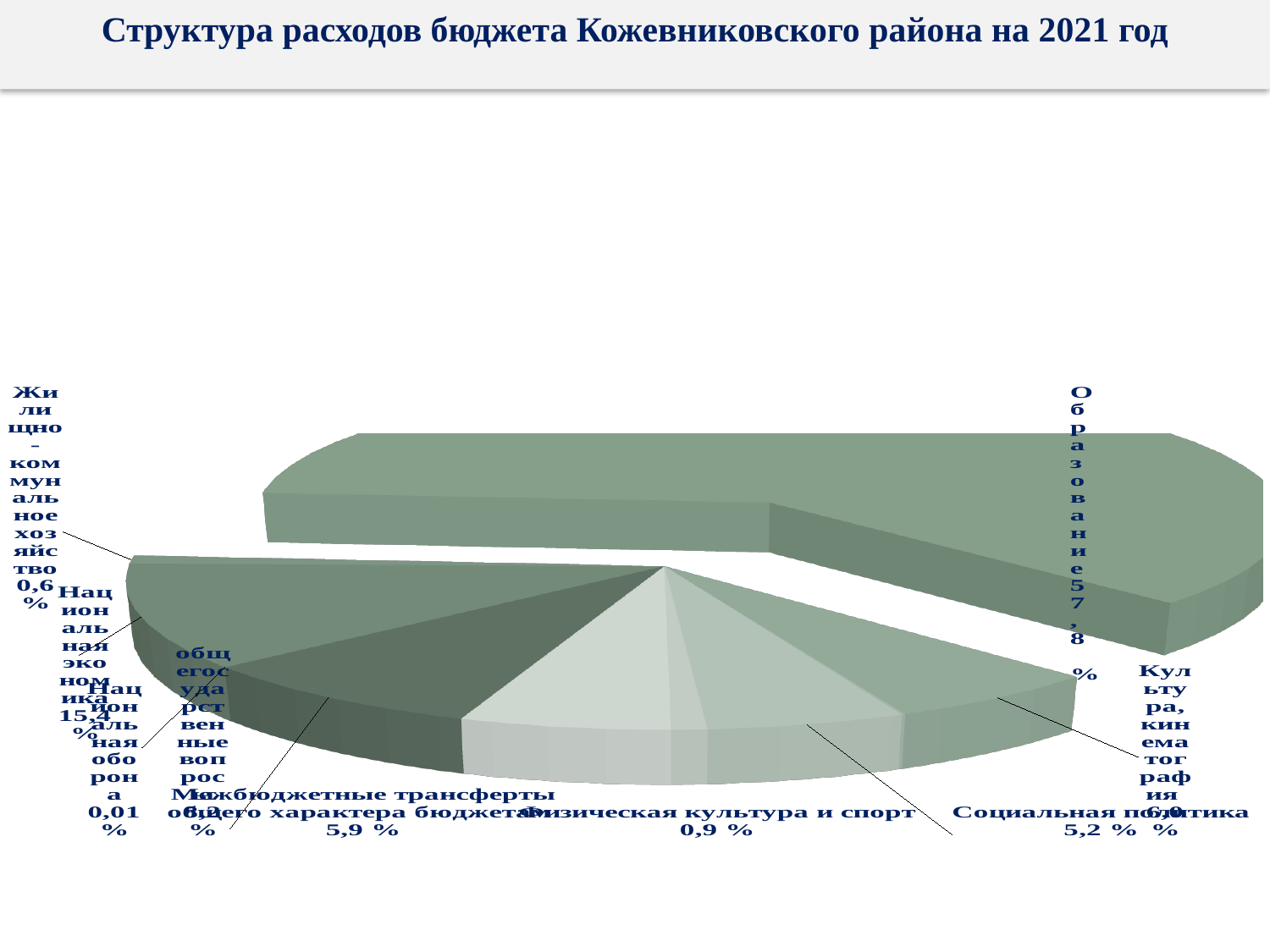
What share of the budget expenditure goes to Социальная политика? 5,2 % Which has a larger share: Социальная политика or Культура, кинематография? Культура, кинематография What share of the budget expenditure goes to Физическая культура и спорт? 0,9 % What share of the budget expenditure goes to Образование? 57,8 % What is the title of the chart? Структура расходов бюджета Кожевниковского района на 2021 год Which expenditure category has the largest share of the budget? Образование How many percentage points larger is the share of Образование than the share of Национальная экономика? 42,4 % What share of the budget expenditure goes to Культура, кинематография? 6,0 % What share of the budget expenditure goes to Жилищно-коммунальное хозяйство? 0,6 % What kind of chart is shown on the slide? pie chart Which expenditure category has the smallest share of the budget? Национальная оборона What share of the budget expenditure goes to Национальная экономика? 15,4 %